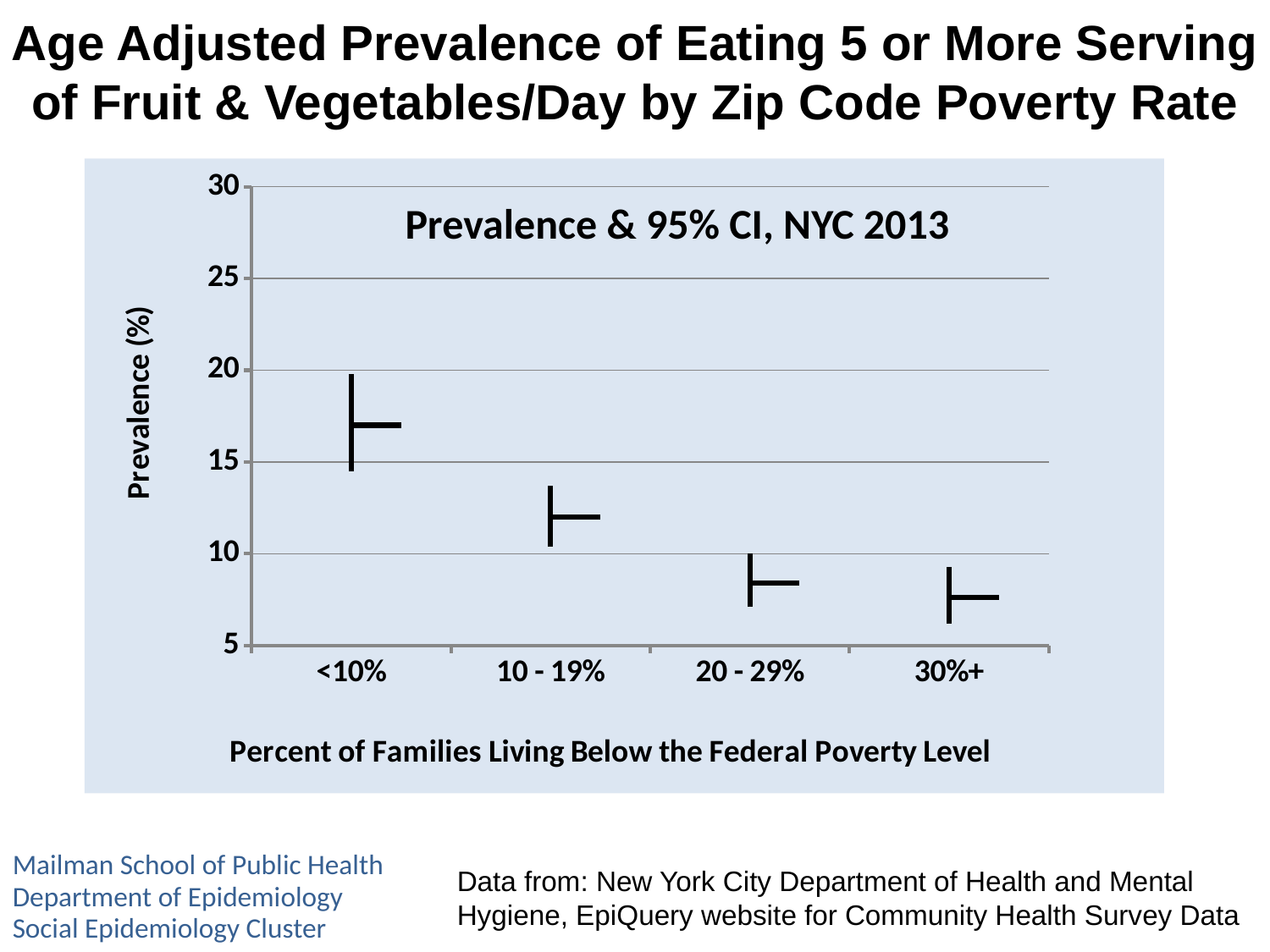
Is the prevalence for the <10% category greater or less than 15? greater Which poverty-rate category has the highest prevalence? <10% Is the prevalence for the 20 - 29% category greater or less than 10? less Does prevalence rise or fall as the zip code poverty rate increases along the x axis? fall Is the prevalence for the 10 - 19% category greater or less than 10? greater Which has the higher prevalence, the <10% category or the 10 - 19% category? <10% Which has the higher prevalence, the 10 - 19% category or the 30%+ category? 10 - 19% What is the title shown inside the chart area? Prevalence & 95% CI, NYC 2013 What is the label of the x axis? Percent of Families Living Below the Federal Poverty Level How many poverty-rate categories are plotted on the x axis? 4